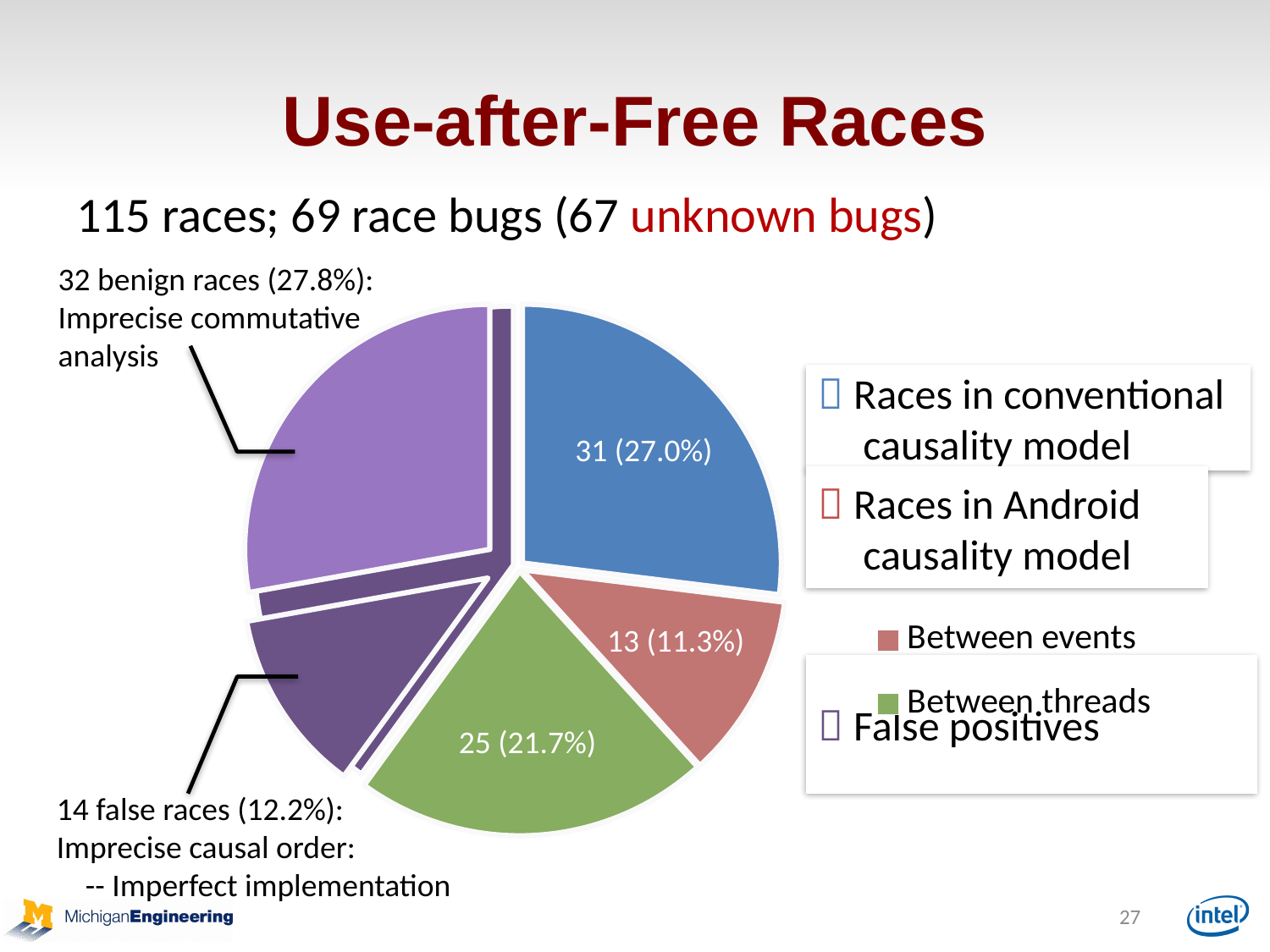
Which slice is larger, the blue slice or the green slice? the blue slice What share of the pie does the red slice represent? 11.3% What is the difference between the count on the blue slice and the count on the red slice? 18 What value is printed on the blue slice of the pie chart? 31 (27.0%) What share of the pie does the green slice represent? 21.7% What value is printed on the green slice of the pie chart? 25 (21.7%) How many benign races does the annotation on the pie chart report? 32 (27.8%) How many false races does the annotation on the pie chart report? 14 (12.2%) What value is printed on the red slice of the pie chart? 13 (11.3%) What kind of chart is shown on the slide? pie chart What is the title of the slide containing the pie chart? Use-after-Free Races